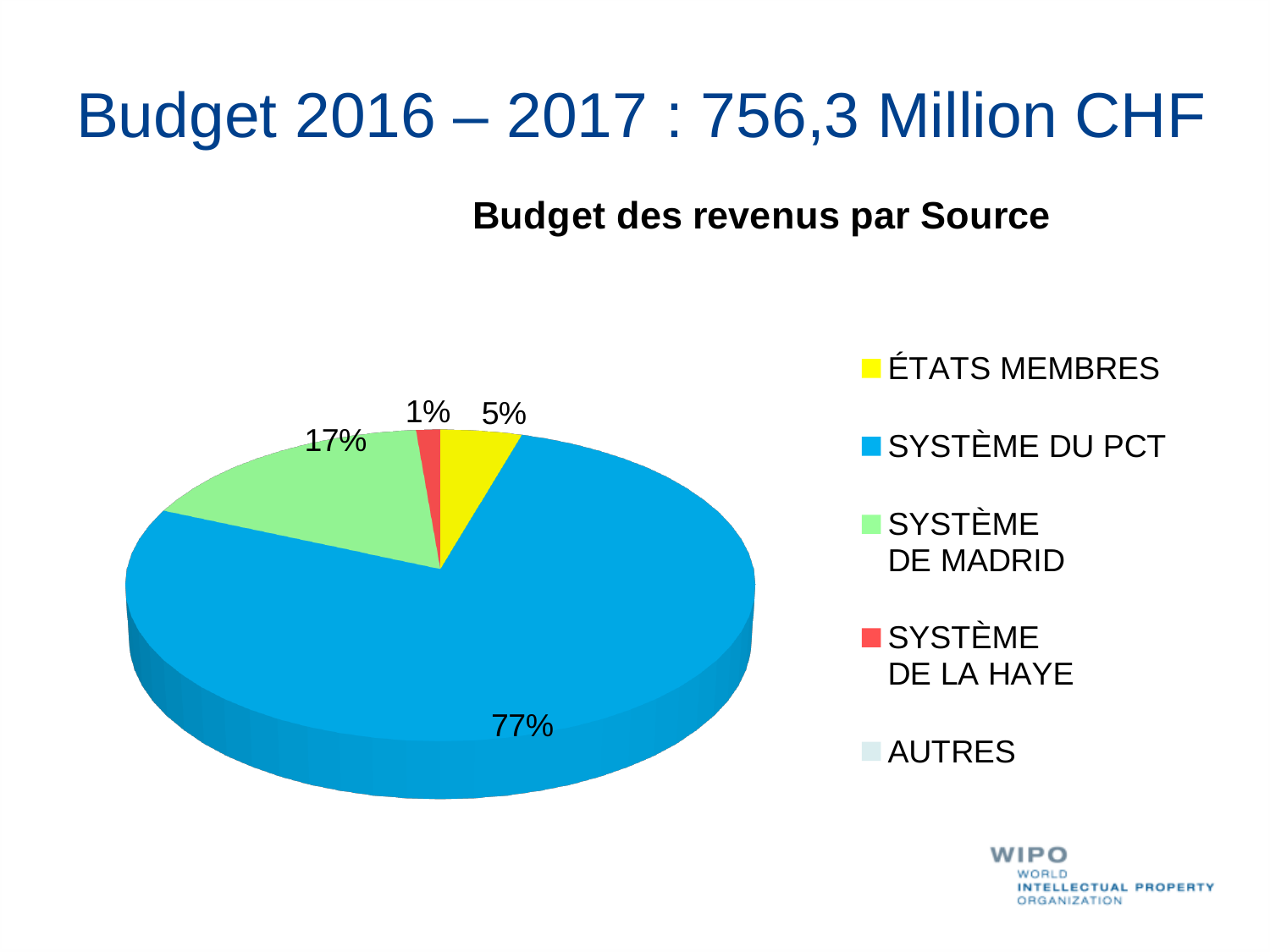
What percentage is shown for SYSTÈME DE MADRID? 17% What percentage is shown for ÉTATS MEMBRES? 5% Which labelled slice has the smallest share? SYSTÈME DE LA HAYE Which is larger, the share for ÉTATS MEMBRES or the share for SYSTÈME DE MADRID? SYSTÈME DE MADRID What percentage is shown for SYSTÈME DE LA HAYE? 1% What share of the pie does SYSTÈME DU PCT account for? 77% What colour represents SYSTÈME DU PCT in the chart? Blue How many entries does the legend list? 5 Which source has the largest share of the budget revenue? SYSTÈME DU PCT What is the title of the chart? Budget des revenus par Source What is the difference in percentage points between SYSTÈME DU PCT and SYSTÈME DE MADRID? 60 What kind of chart is shown on the slide? Pie chart